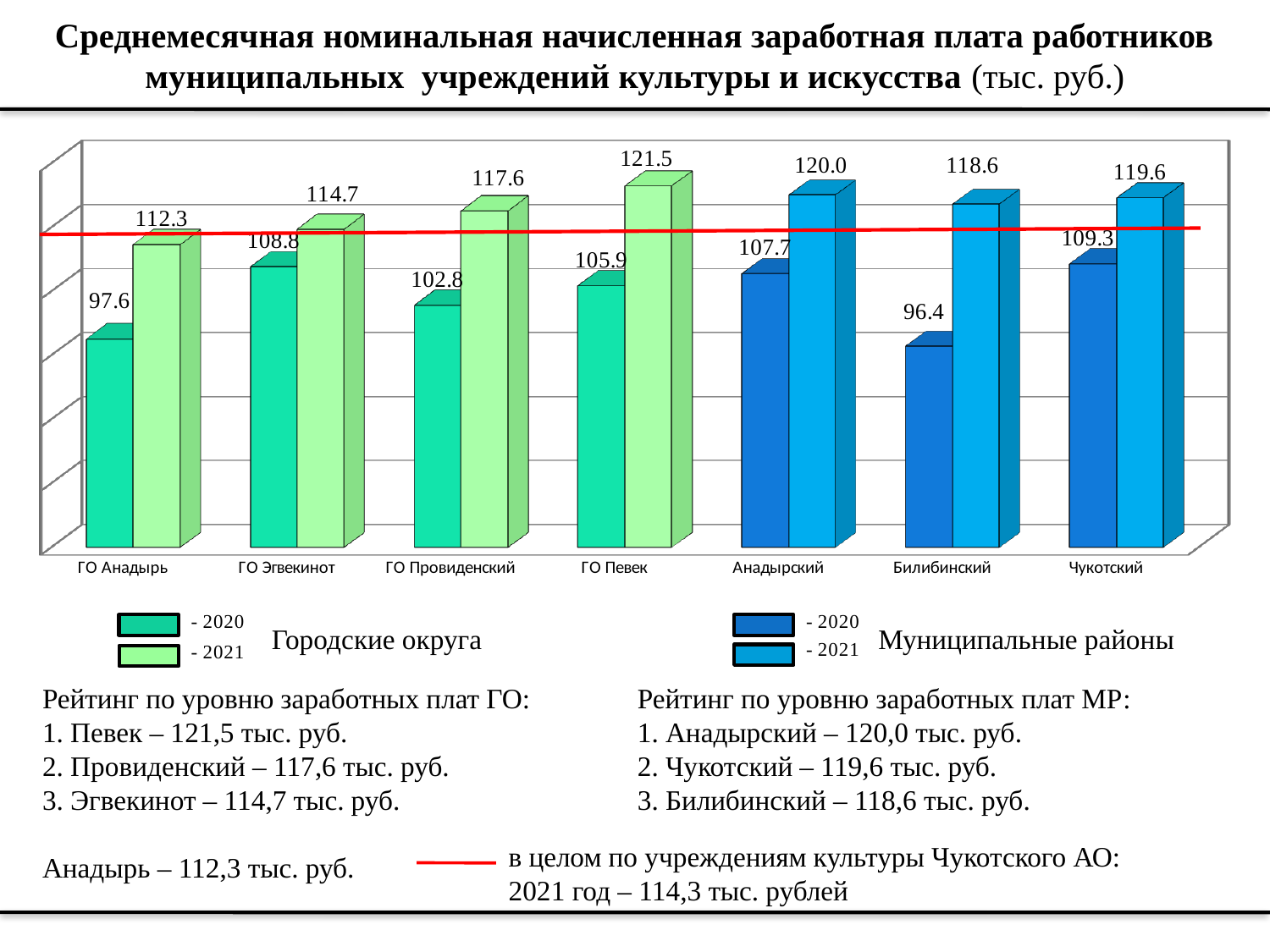
What kind of chart is shown on the slide? bar chart Which two years are listed in the legend? 2020 and 2021 What is the difference between the 2021 and 2020 values for Билибинский? 22.2 What is the 2021 value for ГО Анадырь? 112.3 What is the 2020 value for Билибинский? 96.4 How many categories are shown on the x axis? 7 Which category has the lowest 2020 value? Билибинский What is the difference between the 2021 values for ГО Певек and ГО Анадырь? 9.2 Which category has the highest 2021 value? ГО Певек What is the 2021 value for ГО Певек? 121.5 What value does the red horizontal line represent, according to the slide? 114,3 тыс. рублей Which is larger, the 2020 value for Чукотский or the 2020 value for Анадырский? Чукотский